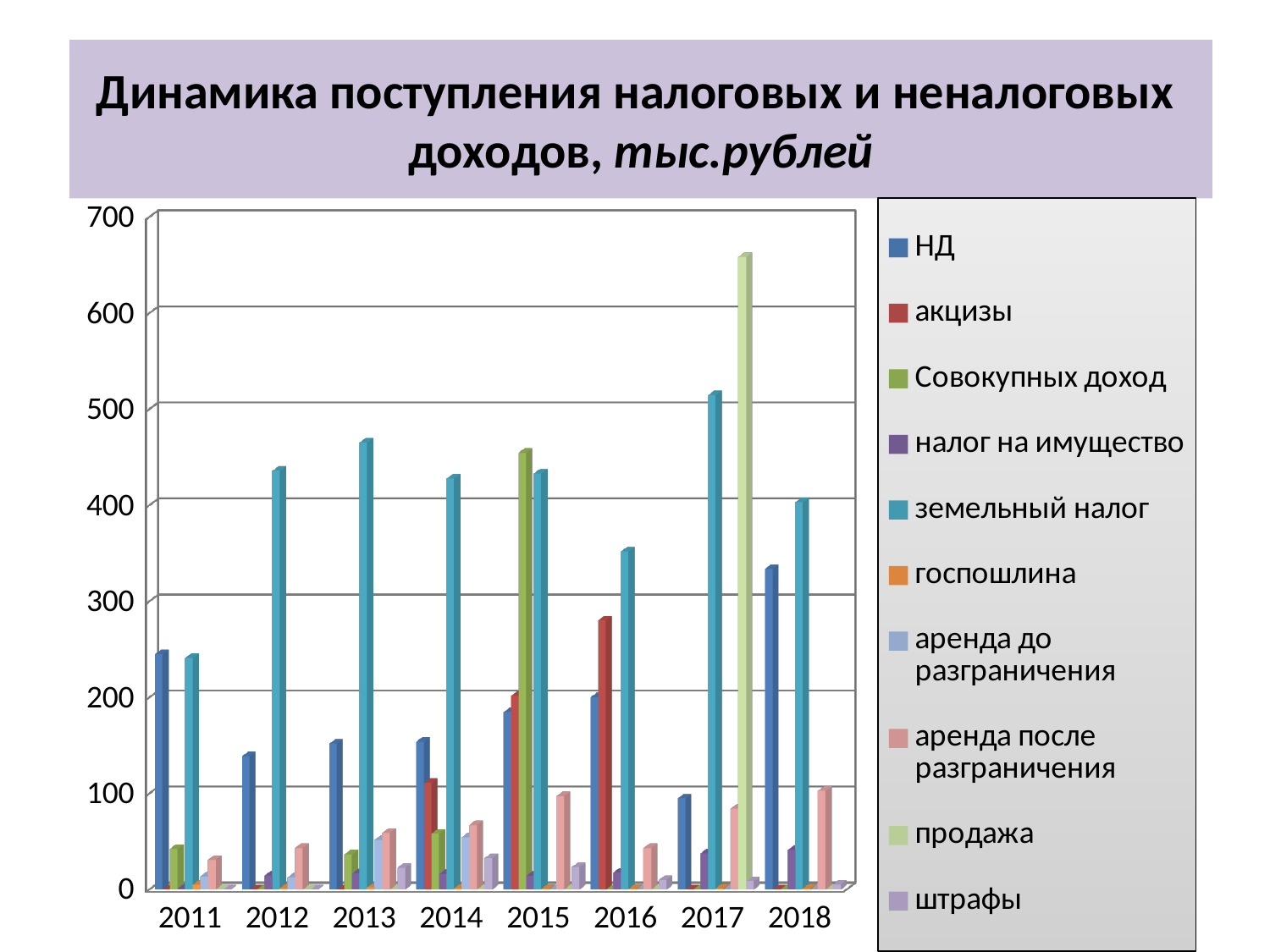
Is the value for продажа in 2017 greater or less than 600? greater Which is larger: земельный налог in 2013 or земельный налог in 2016? 2013 In which year is the value for земельный налог the highest? 2017 In which year is the value for НД the highest? 2018 How many years are shown on the x axis of the chart? 8 Is the value for Совокупных доход in 2015 greater or less than 400? greater Is the value for НД in 2018 greater or less than 300? greater What kind of chart is shown on the slide? bar chart Does the value for земельный налог rise or fall from 2011 to 2013? rise How many series does the legend list? 10